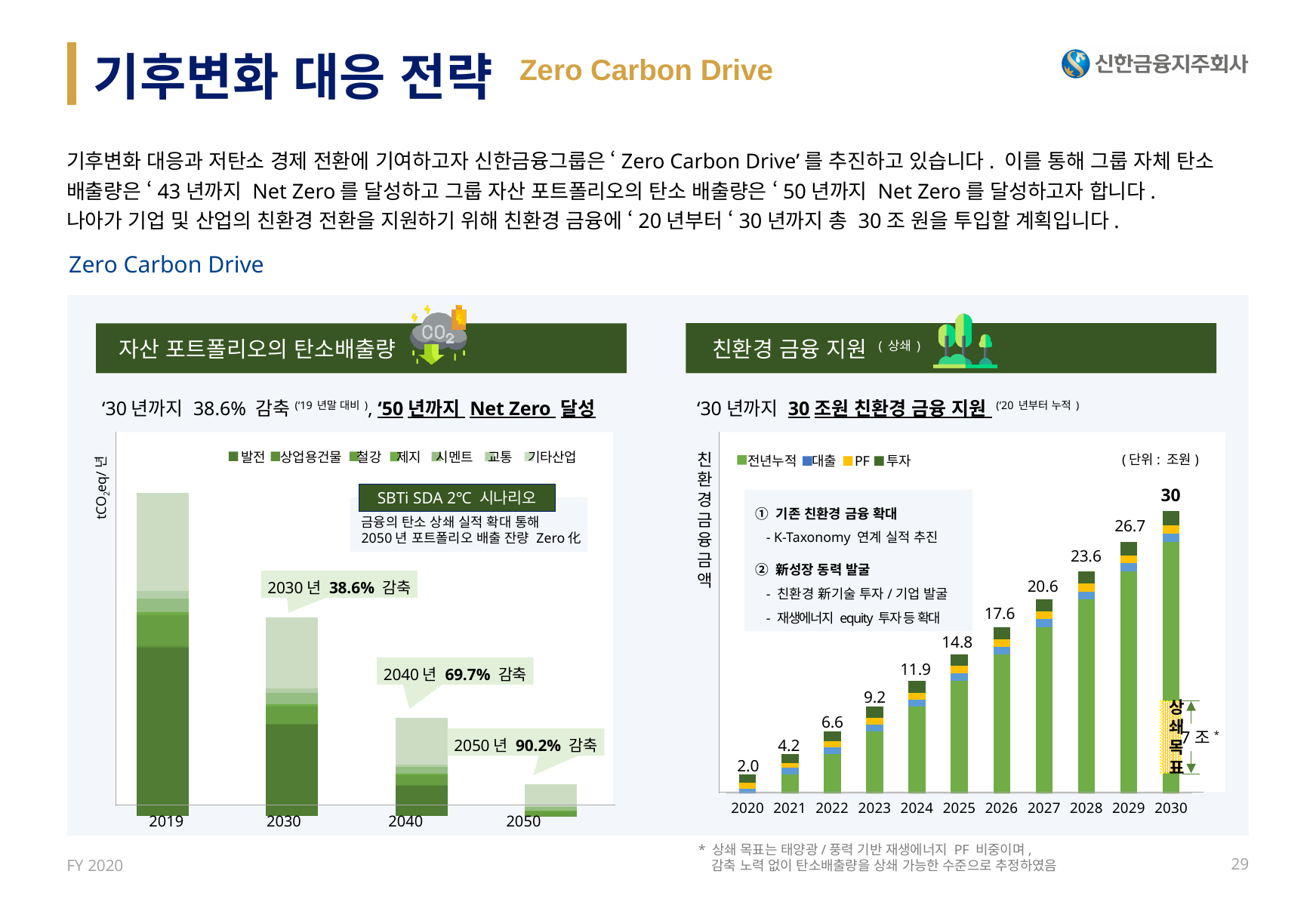
In the 친환경 금융 지원 chart on the right, how many years are shown on the x axis? 11 In the 친환경 금융 지원 chart on the right, do the values rise or fall from 2020 to 2030? rise In the 친환경 금융 지원 chart on the right, what is the total value labeled for 2030? 30 In the 친환경 금융 지원 chart on the right, how many series does the legend list? 4 In the 친환경 금융 지원 chart on the right, what is the difference between the values for 2029 and 2028? 3.1 In the 자산 포트폴리오의 탄소배출량 chart on the left, how many series does the legend list? 7 In the 친환경 금융 지원 chart on the right, which year has the lowest value? 2020 In the 친환경 금융 지원 chart on the right, what is the value labeled for 2025? 14.8 In the 친환경 금융 지원 chart on the right, which is larger, the value for 2023 or the value for 2024? 2024 In the 친환경 금융 지원 chart on the right, which year has the highest value? 2030 In the 친환경 금융 지원 chart on the right, what is the value labeled for 2020? 2.0 What kind of chart is the 자산 포트폴리오의 탄소배출량 chart on the left? stacked bar chart